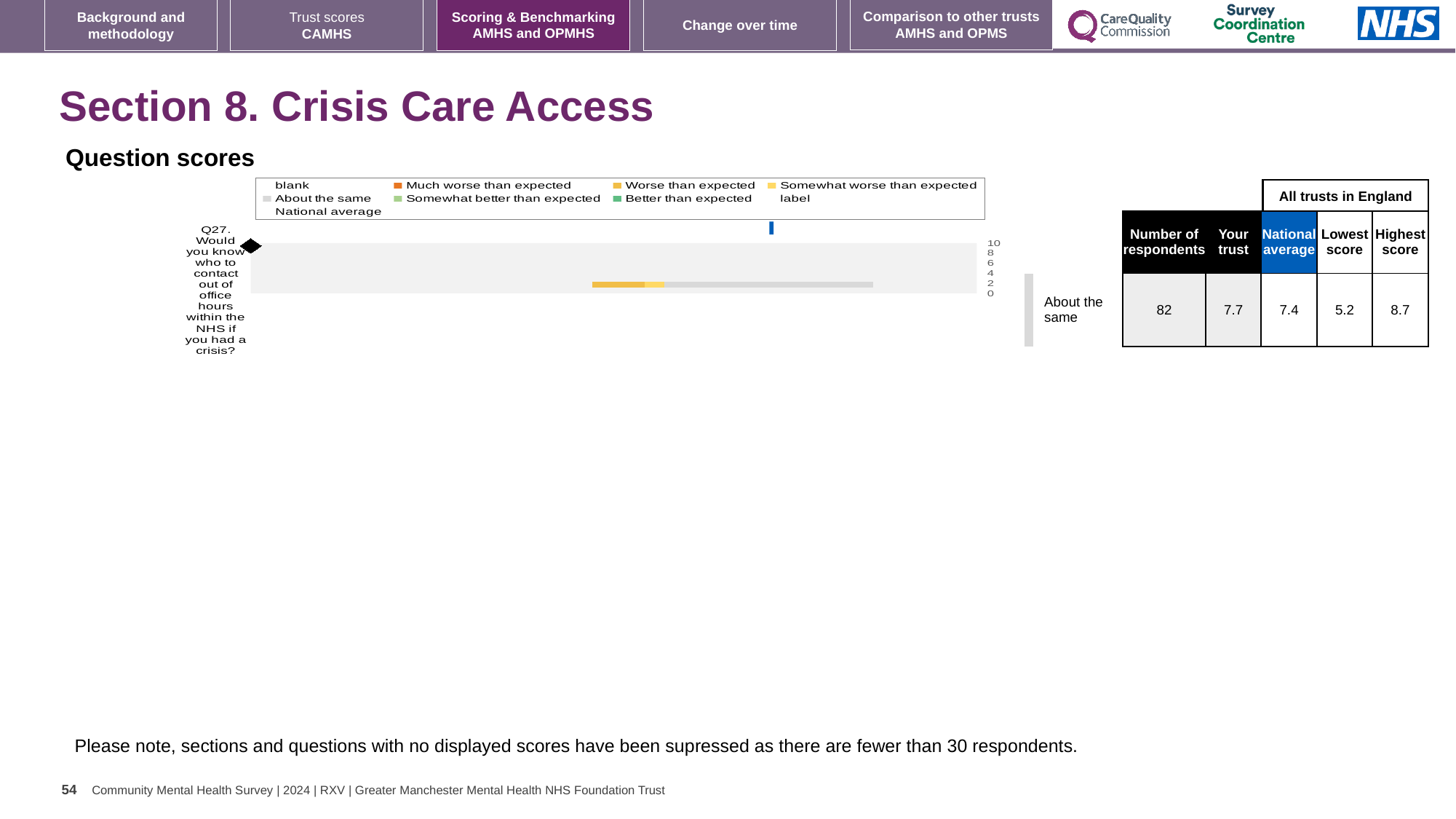
How many questions are plotted in the Question scores chart? 1 What kind of chart is used to show the Q27 question score? bar chart What benchmark label is shown beside the bar for Q27? About the same For Q27, what is the difference between the highest score and the lowest score among all trusts in England? 3.5 In the table beside the chart, what is the national average score for Q27? 7.4 In the table beside the chart, what is the highest score among all trusts in England for Q27? 8.7 In the table beside the chart, what is the lowest score among all trusts in England for Q27? 5.2 In the table beside the chart, how many respondents answered Q27? 82 Which question is plotted in the Question scores chart? Q27. Would you know who to contact out of office hours within the NHS if you had a crisis? For Q27, how much higher is the 'Your trust' score than the national average? 0.3 In the table beside the chart, what is the 'Your trust' score for Q27? 7.7 For Q27, which is larger: the 'Your trust' score or the national average? Your trust